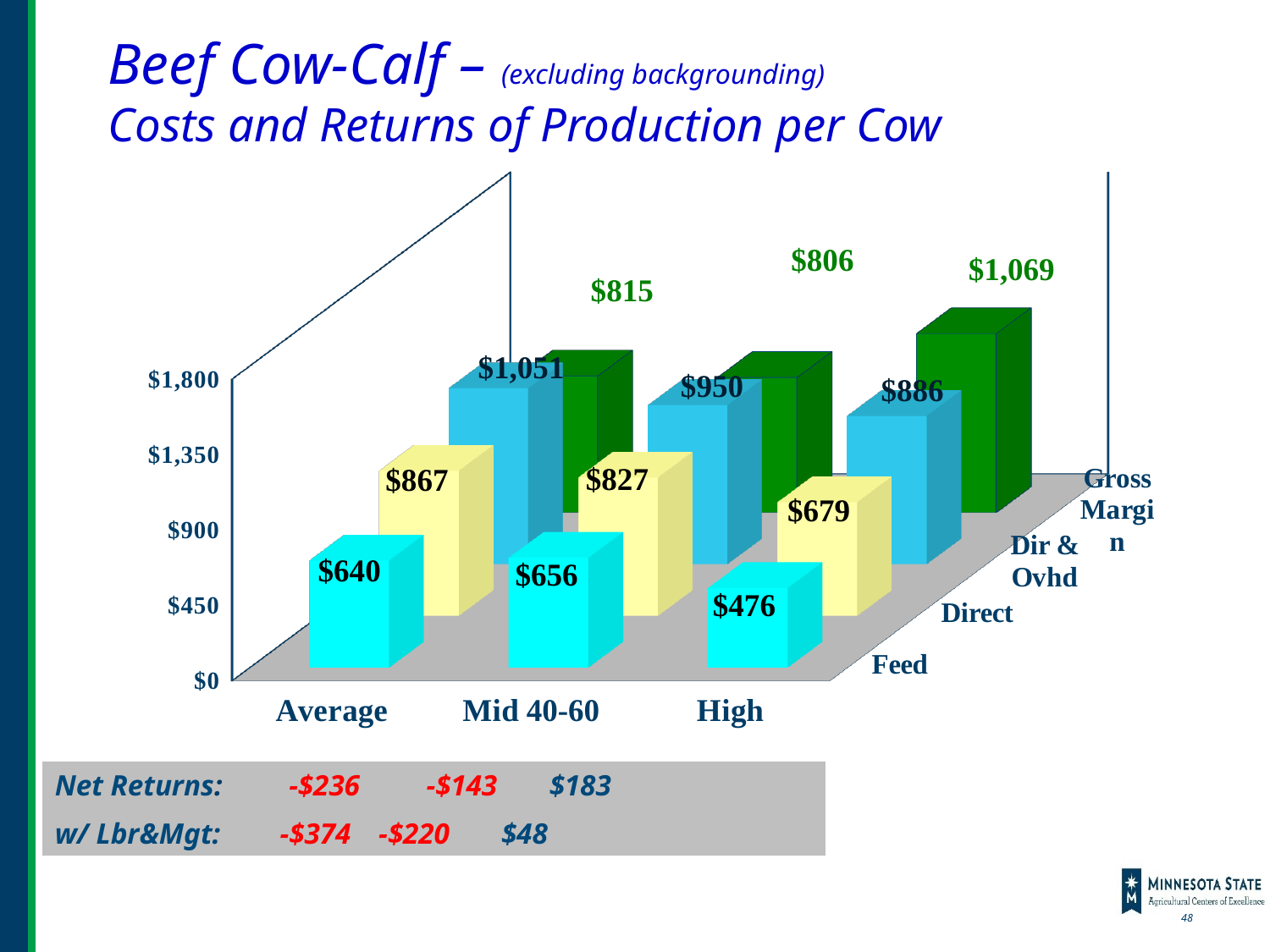
What is the Feed value for the Average group? $640 What is the Dir & Ovhd value for the Mid 40-60 group? $950 Which is larger, the Gross Margin for Average or for Mid 40-60? Average Which group has the highest Dir & Ovhd value? Average What is the Direct value for the High group? $679 What kind of chart is shown on the slide? Bar chart What is the Gross Margin value for the High group? $1,069 What is the difference between the Direct values for Average and High? $188 Do the Feed values rise or fall from Mid 40-60 to High? Fall How many groups are shown on the x axis? 3 Which group has the lowest Feed value? High How many series are plotted in the chart? 4